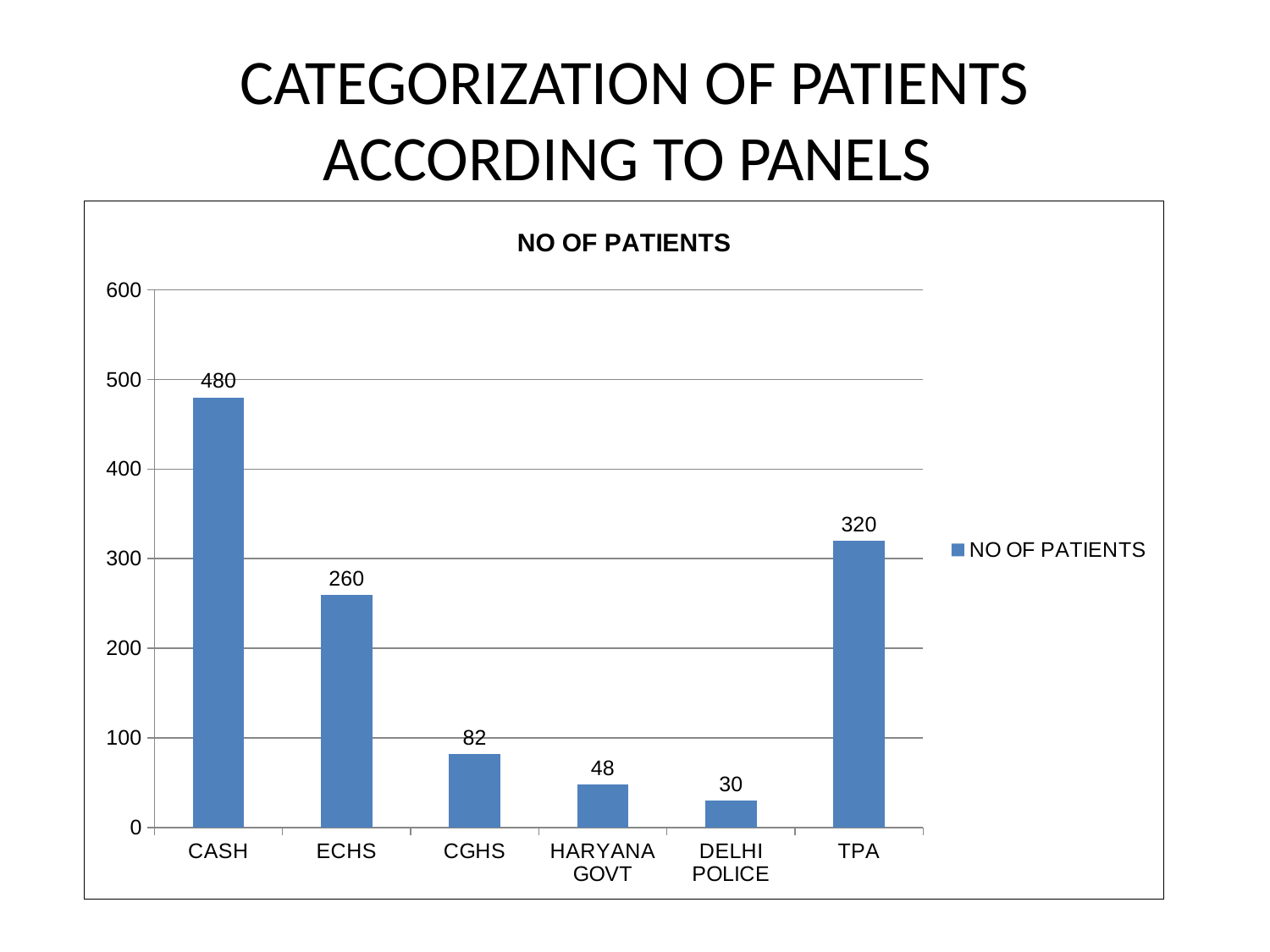
What is the number of patients for HARYANA GOVT? 48 What is the title of the chart? NO OF PATIENTS What is the difference between the number of patients for CASH and TPA? 160 What is the number of patients for CASH? 480 What kind of chart is shown on the slide? bar chart How many categories are shown on the x axis? 6 Which has more patients, ECHS or TPA? TPA What is the difference between the number of patients for CGHS and DELHI POLICE? 52 Is the value for ECHS greater or less than 300? less Which category has the highest number of patients? CASH What is the number of patients for TPA? 320 Which category has the lowest number of patients? DELHI POLICE